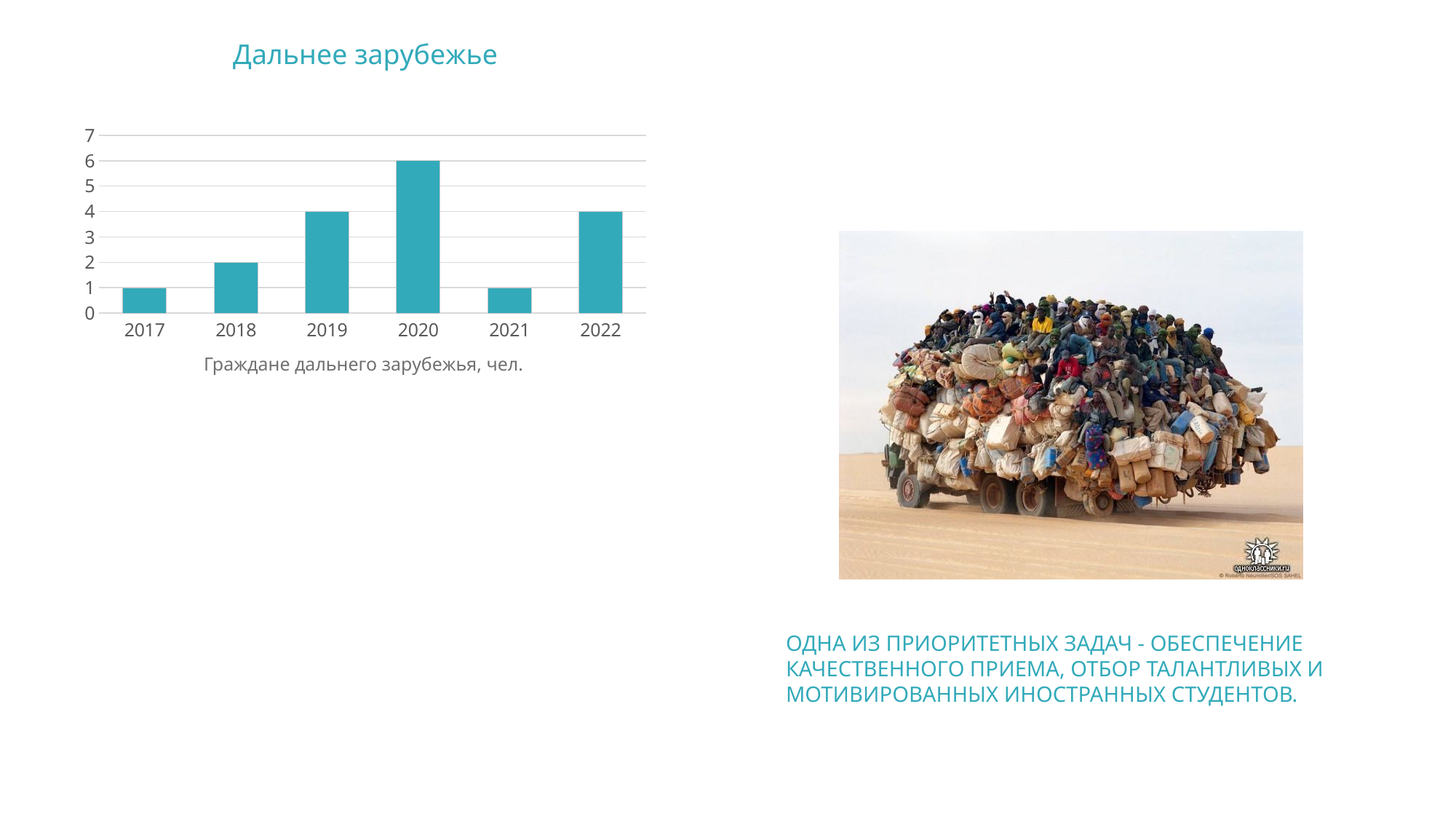
Which is larger, the value for 2019 or the value for 2021? 2019 Is the value for 2020 greater or less than 5? greater What is the difference between the values for 2020 and 2019? 2 What type of chart is shown on the slide? Bar chart Which years have the lowest value? 2017 and 2021 How many years are shown on the x axis? 6 What is the value for 2022? 4 Which year has the highest value? 2020 What is the value for 2018? 2 What is the value for 2020? 6